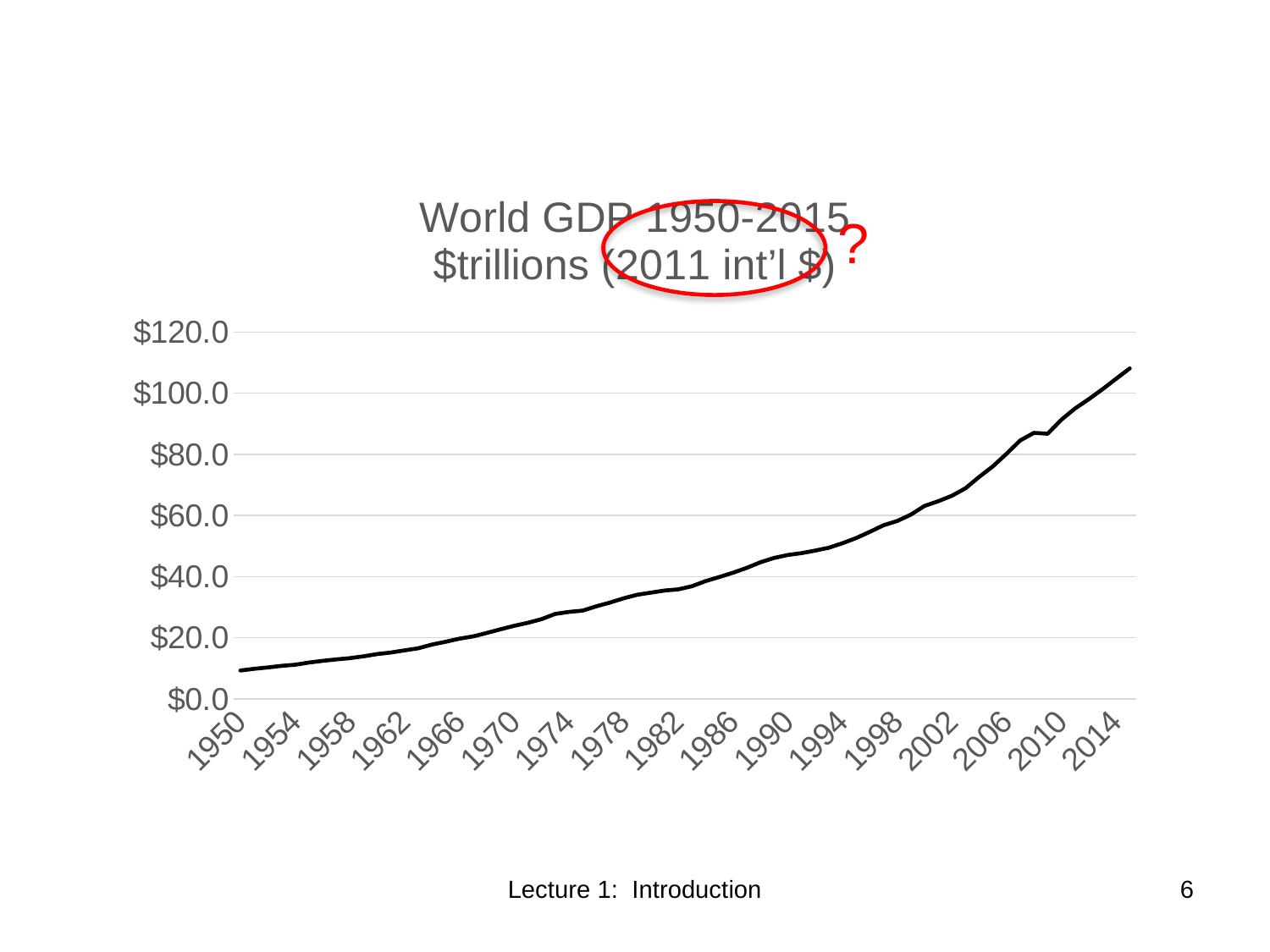
Is the value for 2002 greater or less than $60.0? greater Which is larger, the value for 1966 or the value for 1994? 1994 Is the value for 1990 greater or less than $40.0? greater Do the values rise or fall from 1950 to 2015? rise Is the value for 2010 greater or less than $80.0? greater What kind of chart is shown on the slide? line chart What is the title of the chart? World GDP 1950-2015 $trillions (2011 int'l $) Which year shown on the x axis has the lowest value? 1950